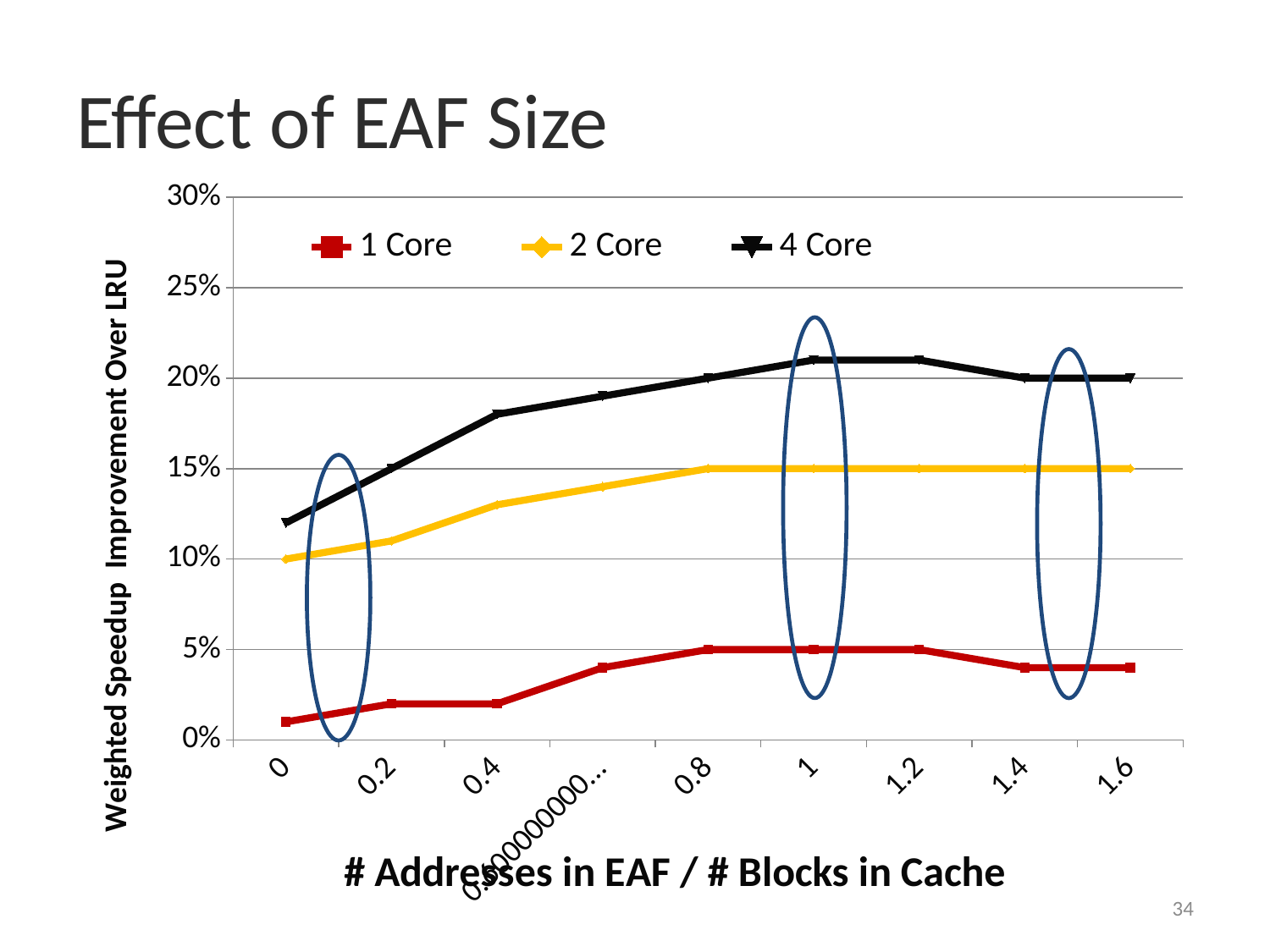
What kind of chart is shown on the slide? line chart Which series has the highest weighted speedup improvement at x = 1? 4 Core Is the value for 4 Core at x = 0 greater or less than 10%? greater What is the value for 4 Core at x = 0.8? 20% What is the value for 1 Core at x = 0.8? 5% Which series has the lowest weighted speedup improvement at x = 0.8? 1 Core What is the value for 2 Core at x = 1.6? 15% What is the title of the slide's chart? Effect of EAF Size How many series does the legend list? 3 What is the value for 2 Core at x = 0? 10% Does the 4 Core series rise or fall from x = 0 to x = 0.8? rise What is the y-axis label of the chart? Weighted Speedup Improvement Over LRU